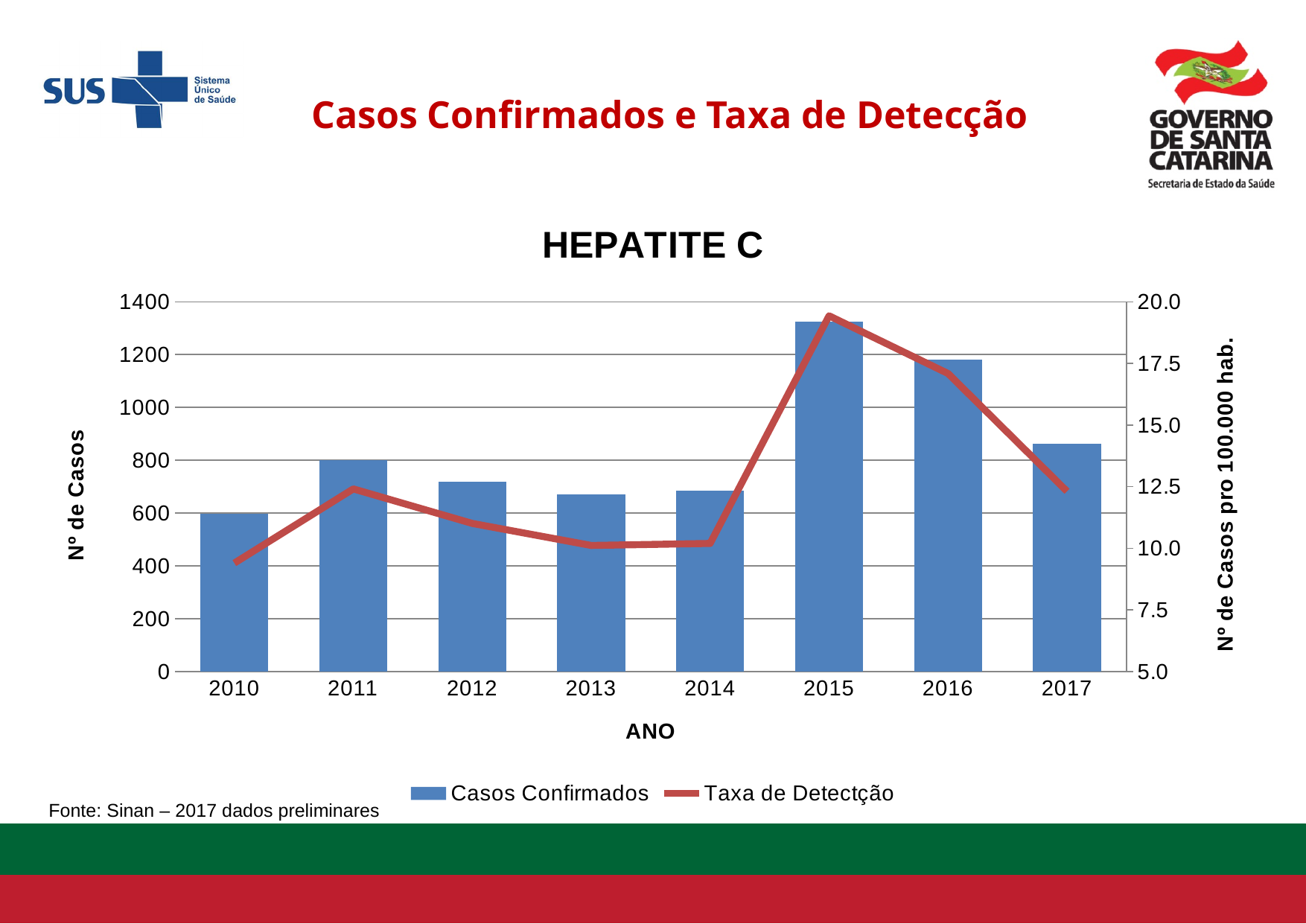
Which year has more confirmed cases, 2015 or 2016? 2015 Which year has the highest number of confirmed cases (Casos Confirmados)? 2015 How many series does the legend list? 2 Is the number of confirmed cases in 2013 greater or less than 800? less Is the detection rate (Taxa de Detectção) in 2010 greater or less than 10.0? less What is the title of the x axis? ANO How many years are shown on the x axis of the HEPATITE C chart? 8 What kind of chart is shown on the slide? bar chart with a line Which year has the lowest number of confirmed cases (Casos Confirmados)? 2010 Do the confirmed cases rise or fall from 2015 to 2017? fall Is the number of confirmed cases in 2015 greater or less than 1200? greater Which year has the highest detection rate (Taxa de Detectção)? 2015